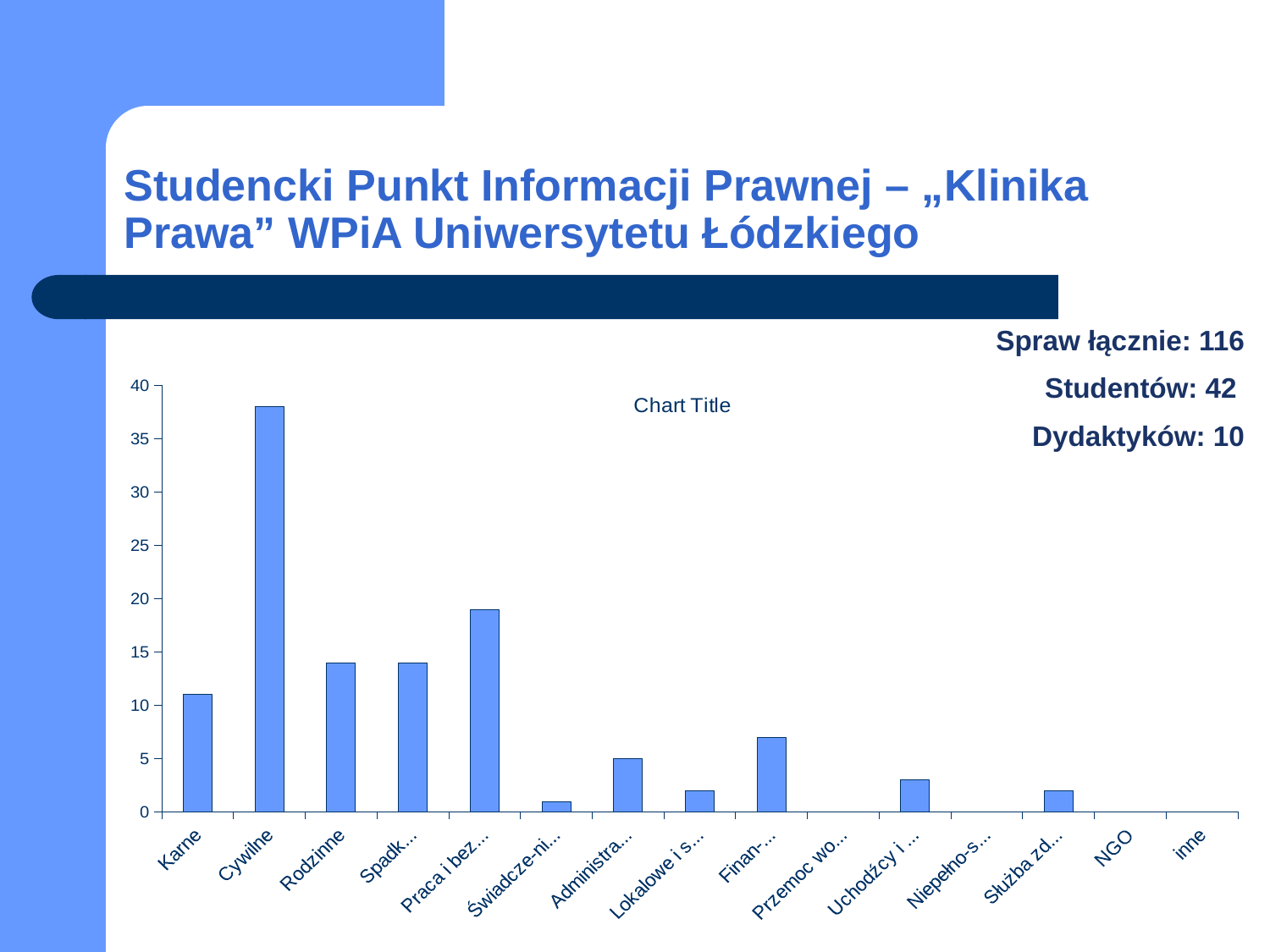
Is the value for Karne greater or less than 15? less Which is larger, the value for Karne or the value for Rodzinne? Rodzinne Which is larger, the value for Cywilne or the value for Rodzinne? Cywilne What title is printed on the chart? Chart Title Which is larger, the value for Karne or the value for Cywilne? Cywilne How many categories are shown on the x axis of the chart? 15 Is the value for Cywilne greater or less than 35? greater Is the value for Rodzinne greater or less than 10? greater What kind of chart is shown on the slide? bar chart Which category has the highest value in the chart? Cywilne